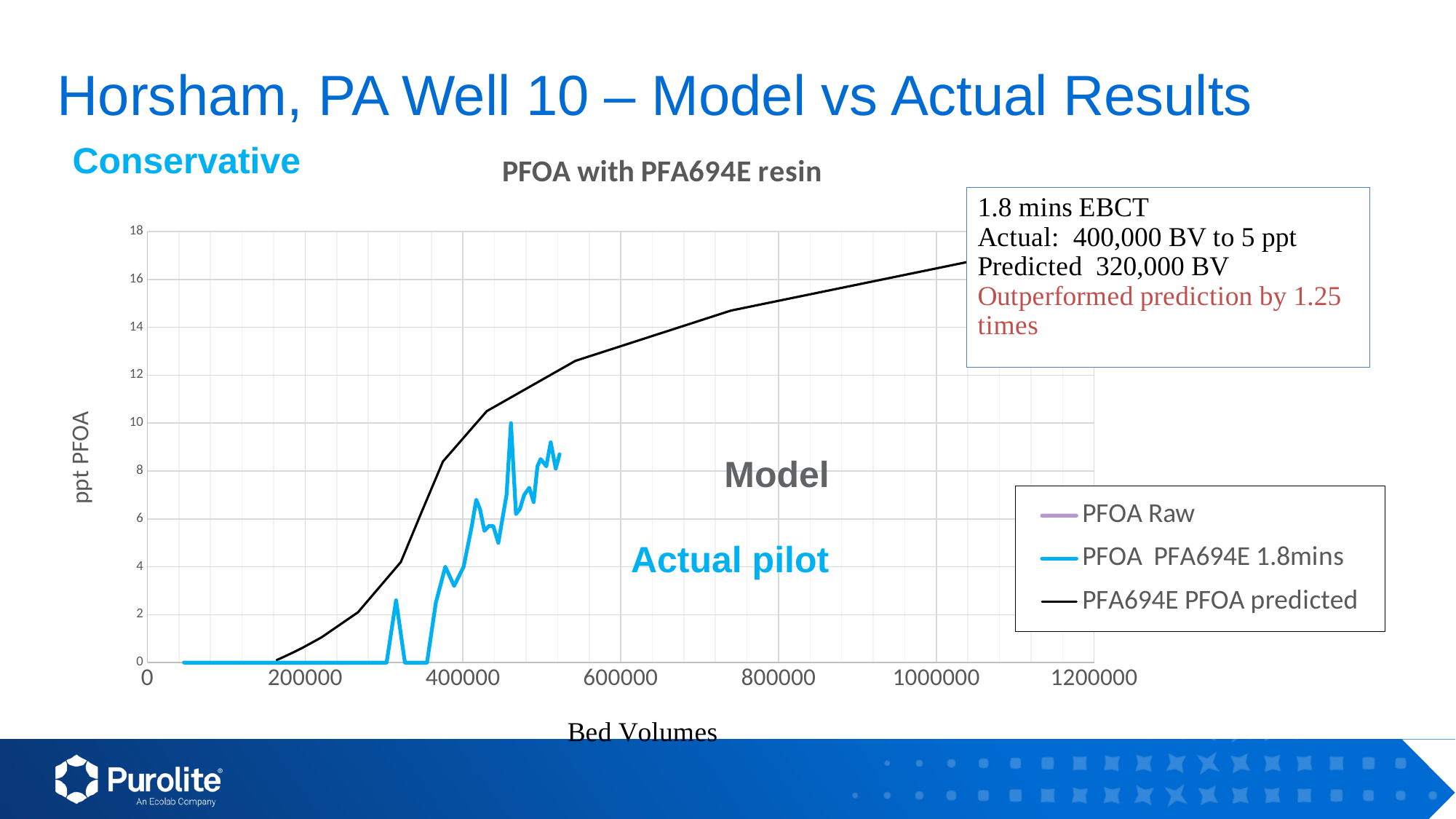
At 400000 bed volumes, which line is higher: PFA694E PFOA predicted or PFOA PFA694E 1.8mins? PFA694E PFOA predicted Is the value of the PFA694E PFOA predicted line at 200000 bed volumes greater or less than 2? less What is the title of the chart? PFOA with PFA694E resin How many series does the chart legend list? 3 What is the label of the y axis? ppt PFOA Is the value of the PFA694E PFOA predicted line at 600000 bed volumes greater or less than 12? greater Is the value of the PFOA PFA694E 1.8mins line at 200000 bed volumes greater or less than 2? less Does the PFA694E PFOA predicted line rise or fall as bed volumes increase? rise What kind of chart is shown on the slide? line chart Which series in the legend is drawn in black? PFA694E PFOA predicted